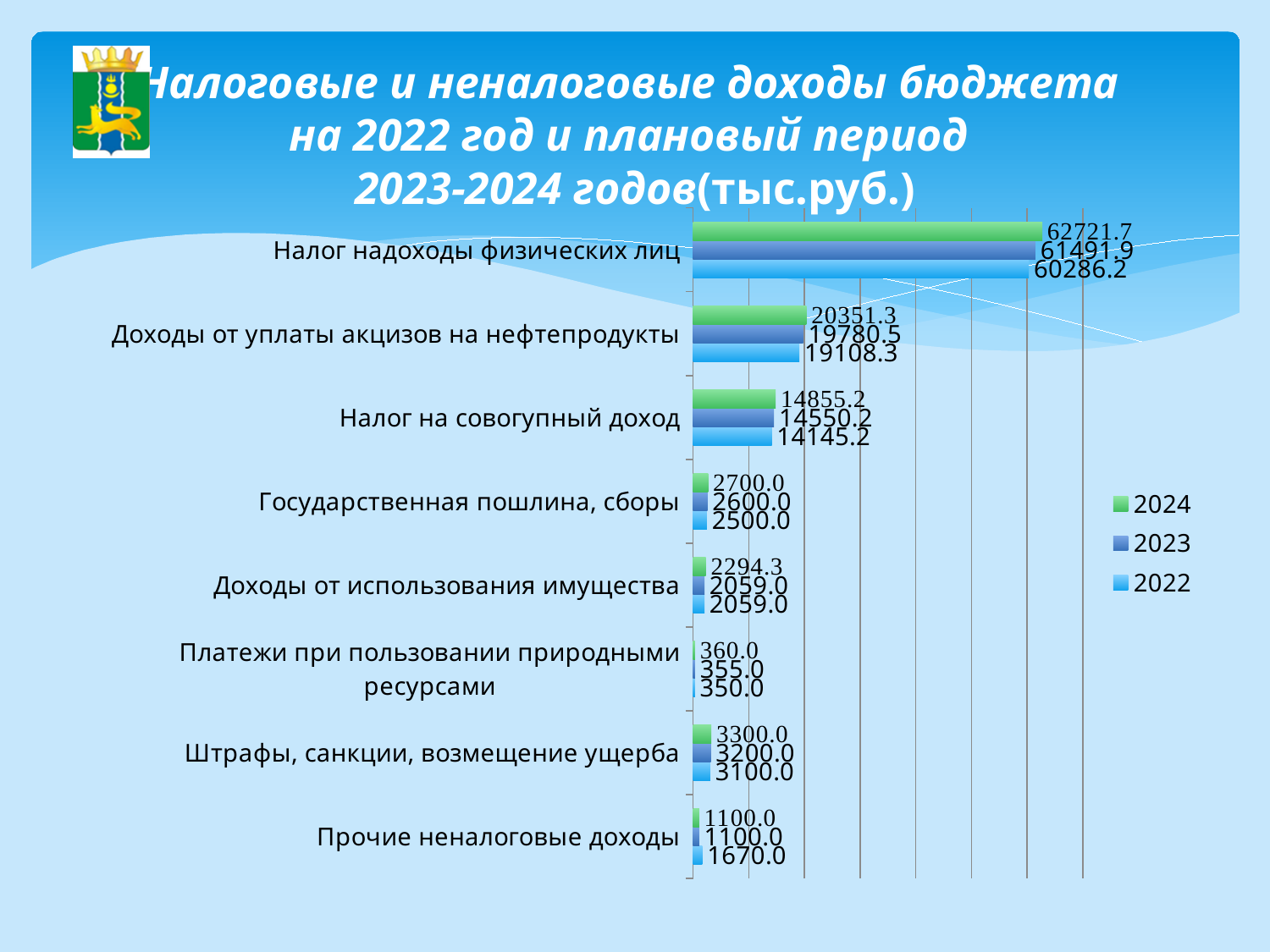
How many series does the legend list? 3 Which legend entry is shown in green? 2024 Which category has the highest 2024 value? Налог на доходы физических лиц What is the 2022 value for Прочие неналоговые доходы? 1670.0 What is the 2022 value for Доходы от уплаты акцизов на нефтепродукты? 19108.3 What type of chart is shown on the slide? bar chart What is the difference between the 2024 and 2022 values for Государственная пошлина, сборы? 200.0 How many categories are shown in the chart? 8 Which category has the lowest 2022 value? Платежи при пользовании природными ресурсами What is the 2023 value for Налог на совокупный доход? 14550.2 Which is larger for Штрафы, санкции, возмещение ущерба: the 2024 value or the 2022 value? 2024 What is the 2024 value for Налог на доходы физических лиц? 62721.7